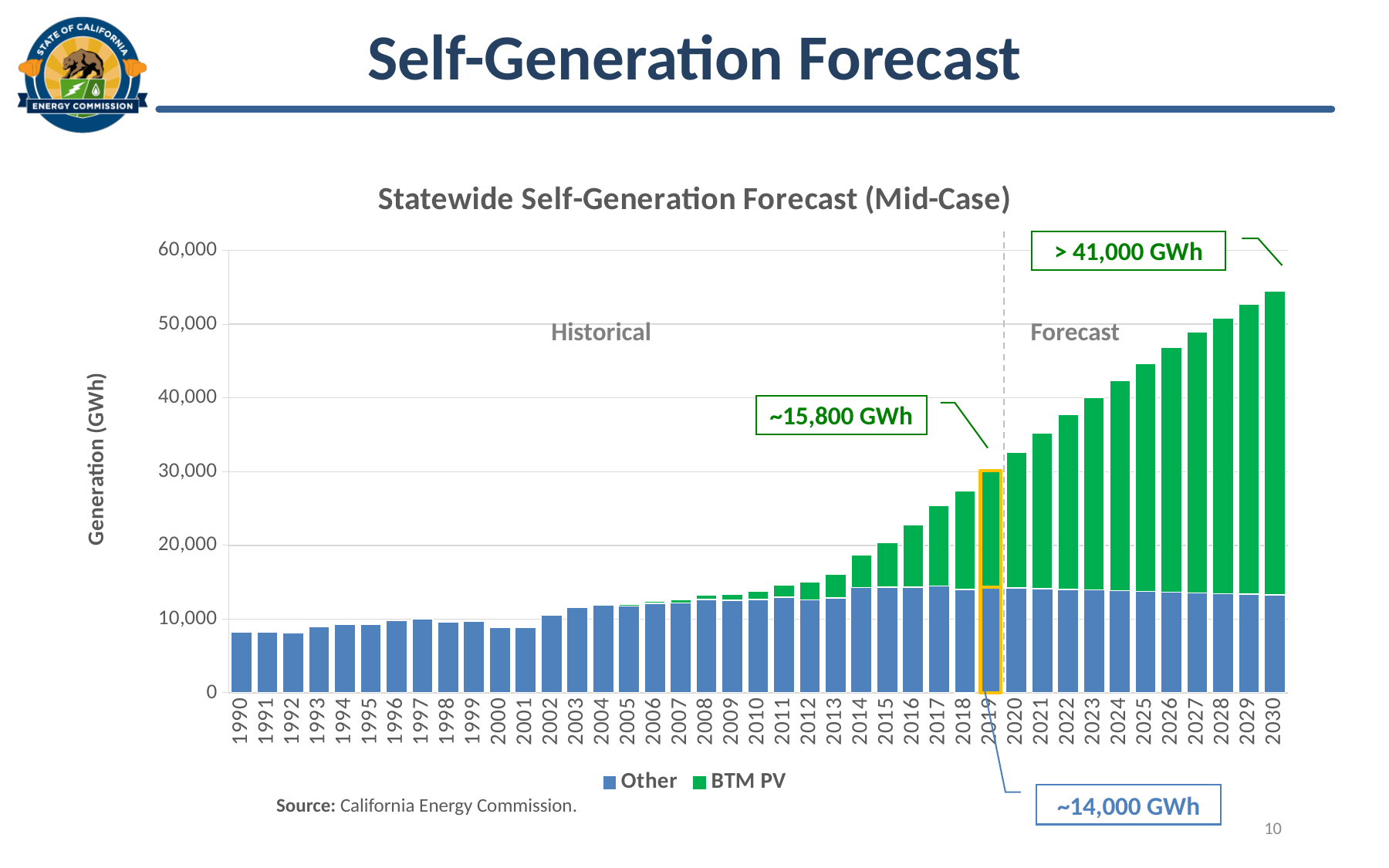
Is the total generation for 1990 greater or less than 10,000? less How many series does the legend list? 2 Which year has the larger total generation, 2019 or 2030? 2030 How many years are shown along the x axis? 41 Is the total generation for 2025 greater or less than 40,000? greater What is the title of the chart? Statewide Self-Generation Forecast (Mid-Case) Which year has the highest total generation? 2030 What kind of chart is shown on the slide? Stacked bar chart Do the total generation values generally rise or fall from 1990 to 2030? rise Is the total generation for 2010 greater or less than 20,000? less What are the two series named in the legend? Other and BTM PV